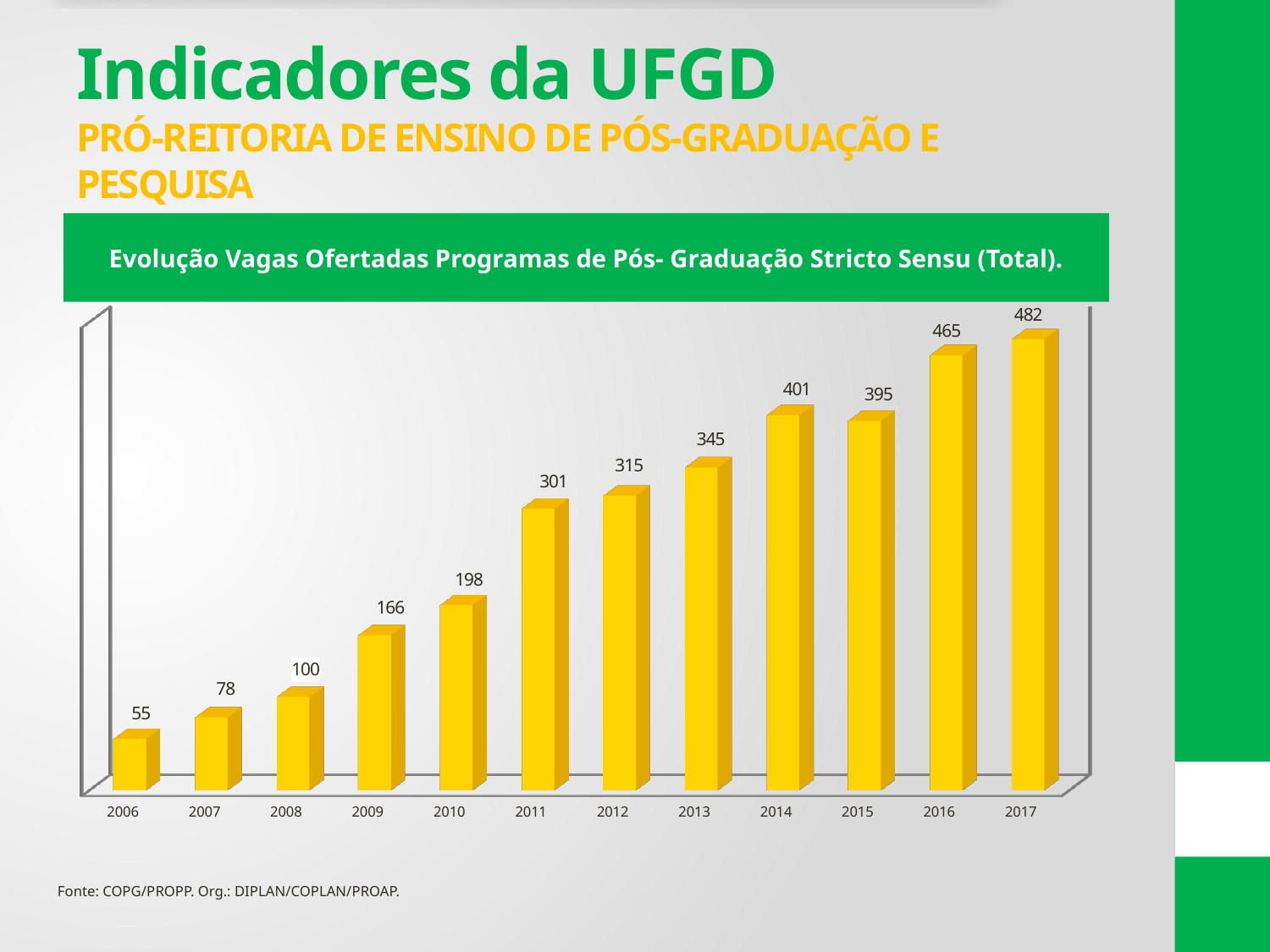
What is the difference between the values for 2017 and 2016? 17 What is the difference between the values for 2014 and 2015? 6 Which year has the lowest value? 2006 Which is larger, the value for 2014 or the value for 2015? 2014 What is the value for 2010? 198 What is the value for 2015? 395 What kind of chart is this? bar chart Do the values generally rise or fall from 2006 to 2017? rise Which year has the highest value? 2017 What colour are the bars? yellow What is the title of the chart? Evolução Vagas Ofertadas Programas de Pós- Graduação Stricto Sensu (Total). How many years are shown on the x axis? 12